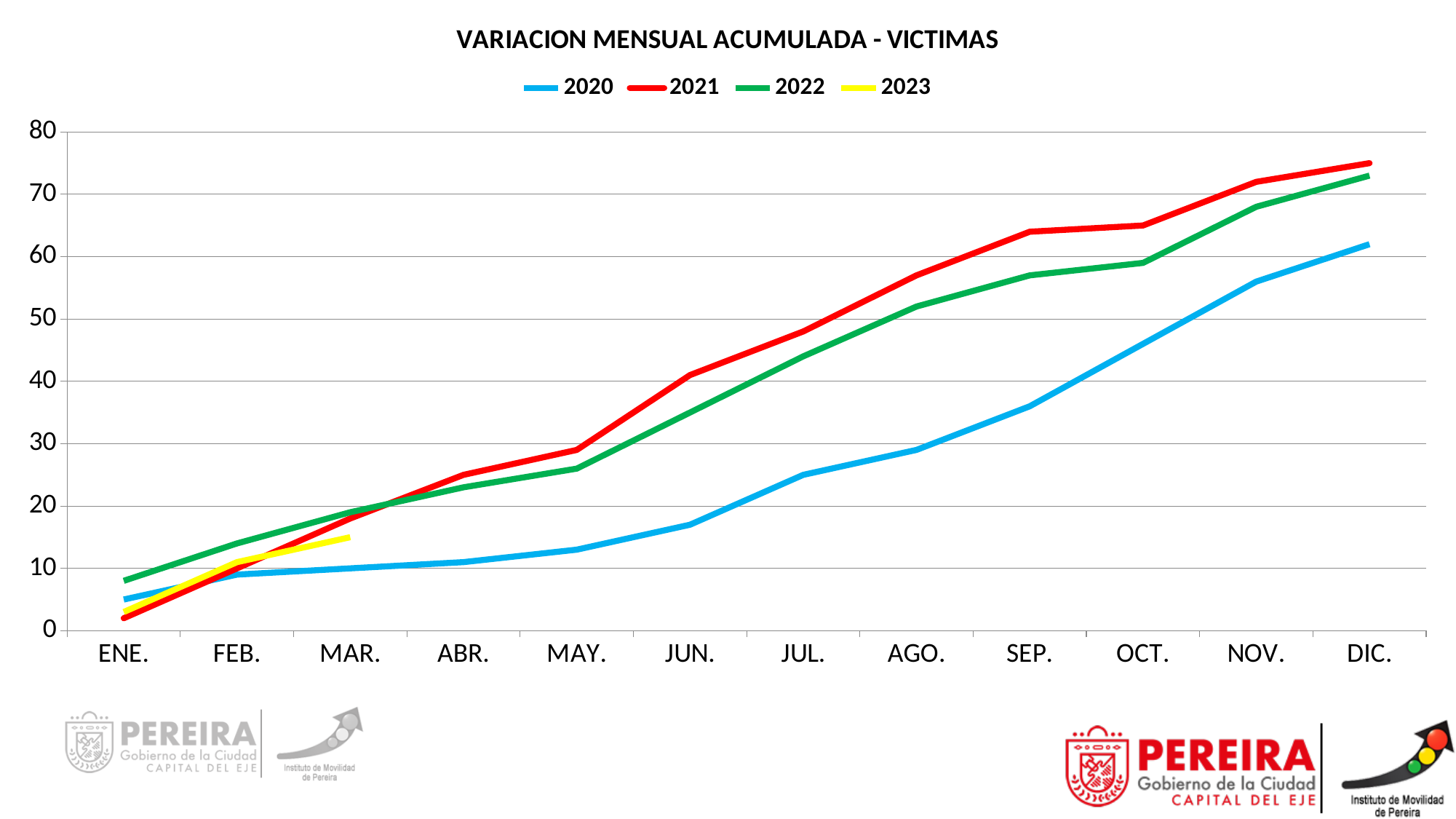
Is the value for 2021 in SEP. greater or less than 60? greater Which colour is used for the 2023 series? yellow Do the values for the 2020 series rise or fall from ENE. to DIC.? rise Is the value for 2021 in AGO. greater or less than 50? greater How many months are shown along the x axis? 12 How many series does the legend list? 4 Which series has the highest value in ENE.? 2022 Is the value for 2020 in SEP. greater or less than 40? less What is the title of the chart? VARIACION MENSUAL ACUMULADA - VICTIMAS What kind of chart is shown on the slide? line chart Which series has the lowest value in DIC.? 2020